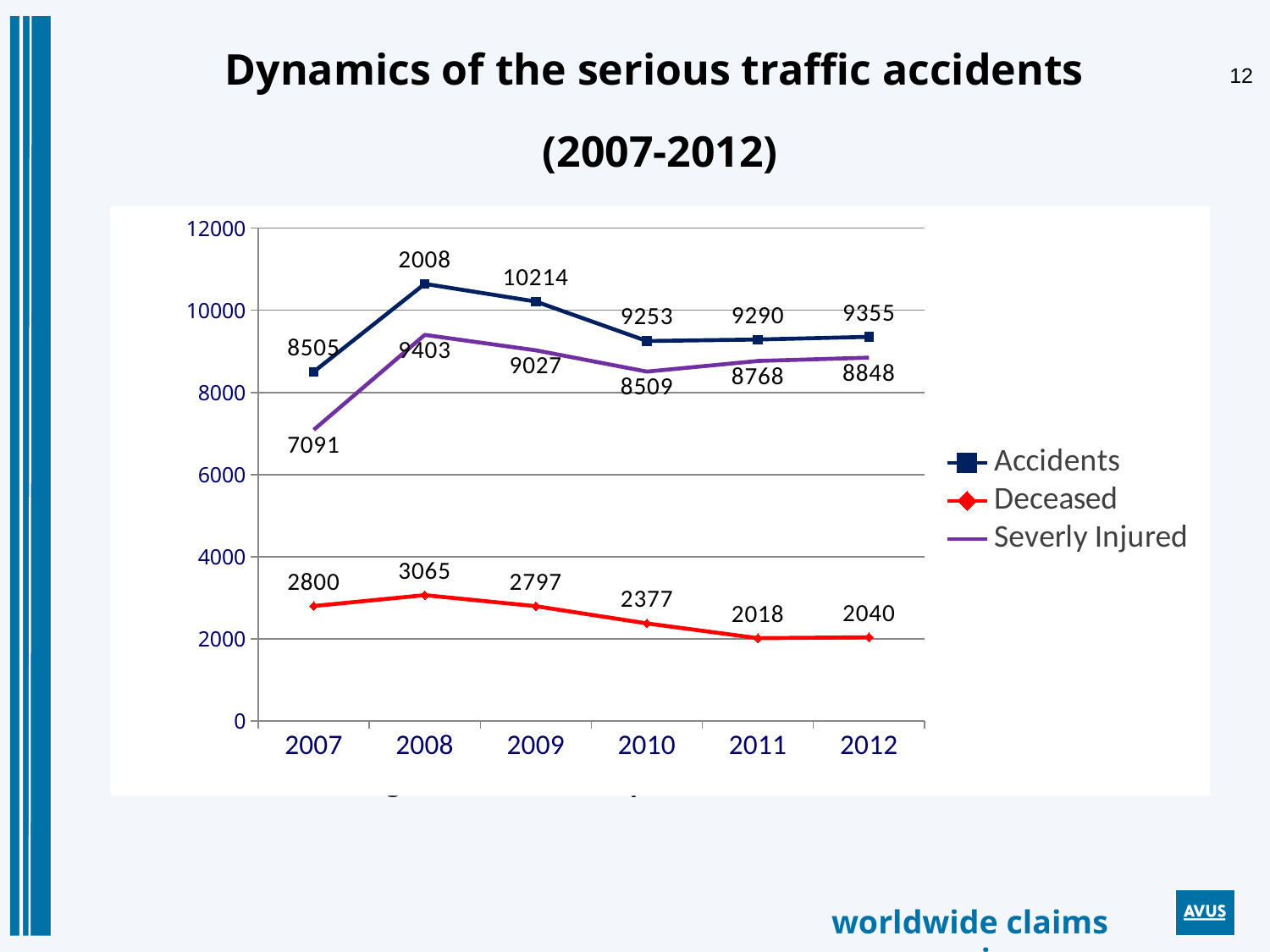
In which year is the Severly Injured value lowest? 2007 Which is larger, the Deceased value in 2010 or the Deceased value in 2012? 2010 Does the Deceased series rise or fall from 2008 to 2011? fall Is the value for Accidents in 2008 greater or less than 10000? greater In which year is the Deceased value highest? 2008 How many series does the legend list? 3 How many years are shown on the x axis? 6 What type of chart is shown on the slide? line chart What is the value for Deceased in 2011? 2018 What is the value for Accidents in 2009? 10214 What is the value for Severly Injured in 2007? 7091 What is the difference between the Accidents value in 2012 and the Accidents value in 2007? 850